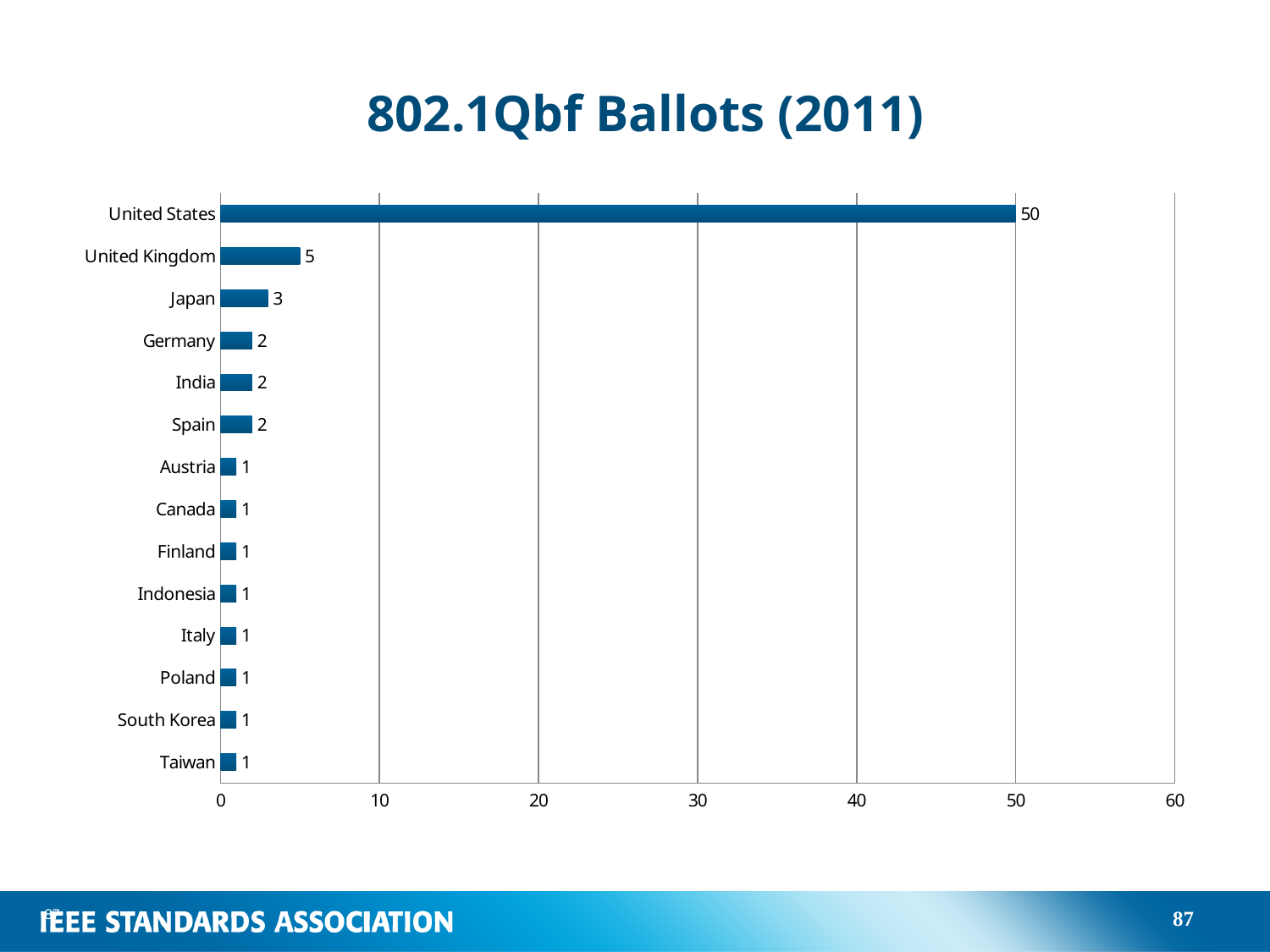
What is the value for Japan? 3 What is the title of the chart? 802.1Qbf Ballots (2011) Which country has the highest number of ballots? United States What is the difference between the values for the United Kingdom and Japan? 2 How many countries are shown in the chart? 14 What kind of chart is shown on the slide? bar chart How many ballots does the United States have? 50 What is the value for the United Kingdom? 5 Is the value for the United States greater or less than 40? greater Which is larger, the value for Japan or the value for Germany? Japan What is the difference between the values for the United States and the United Kingdom? 45 What is the value for Spain? 2